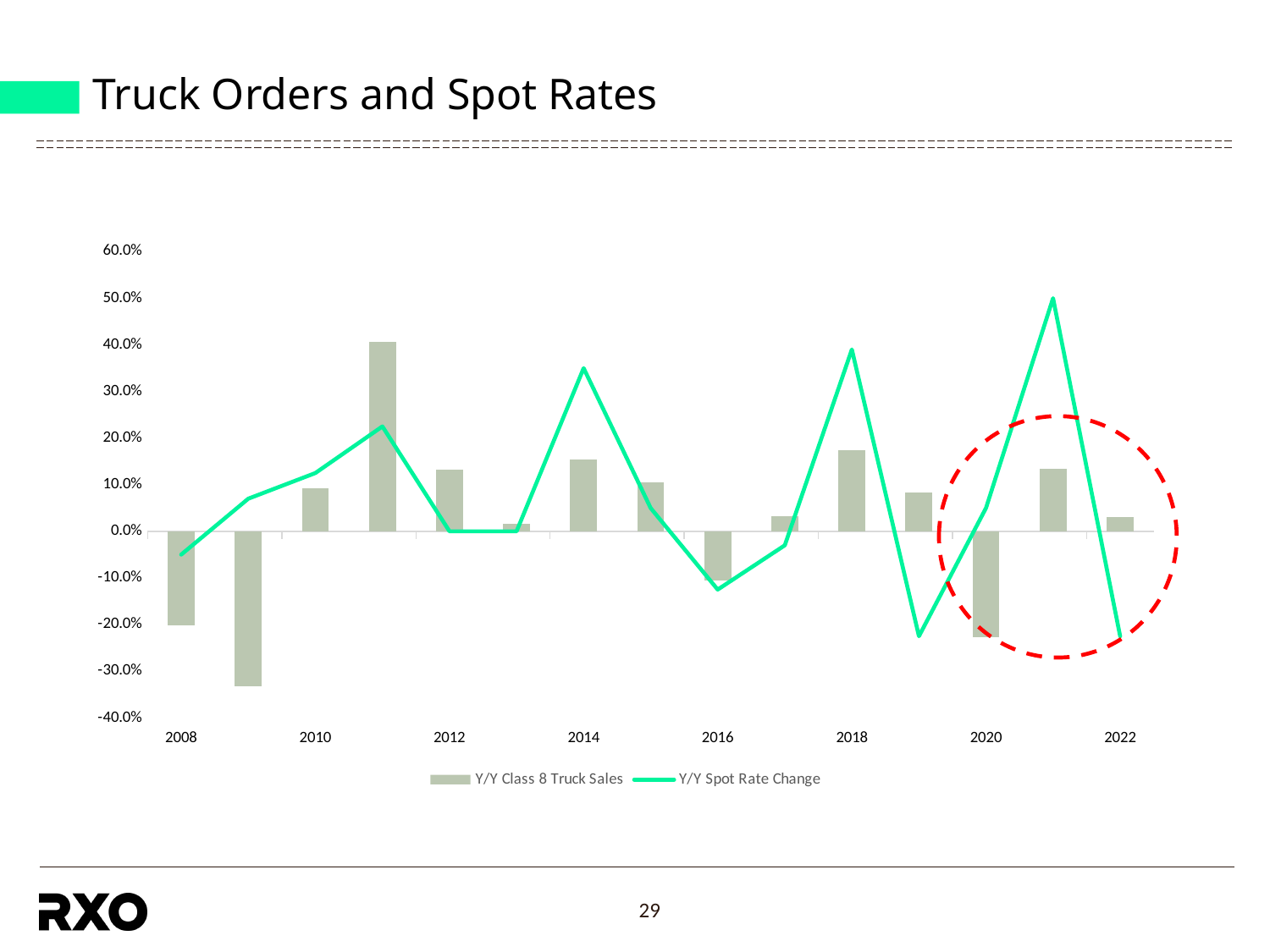
In which year is the Y/Y Class 8 Truck Sales bar the highest? 2011 What kind of chart is this? Combination bar and line chart Is the Y/Y Spot Rate Change value for 2021 greater or less than 40.0%? greater What is the title of the chart? Truck Orders and Spot Rates How many series does the legend list? 2 In which year does the Y/Y Spot Rate Change line reach its highest point? 2021 Does the Y/Y Spot Rate Change line rise or fall from 2021 to 2022? fall Is the Y/Y Class 8 Truck Sales value for 2018 greater or less than 10.0%? greater Which year has the larger Y/Y Class 8 Truck Sales value, 2011 or 2018? 2011 Is the Y/Y Class 8 Truck Sales value for 2009 greater or less than -30.0%? less In which year is the Y/Y Class 8 Truck Sales bar the lowest? 2009 Which series is shown as a line? Y/Y Spot Rate Change